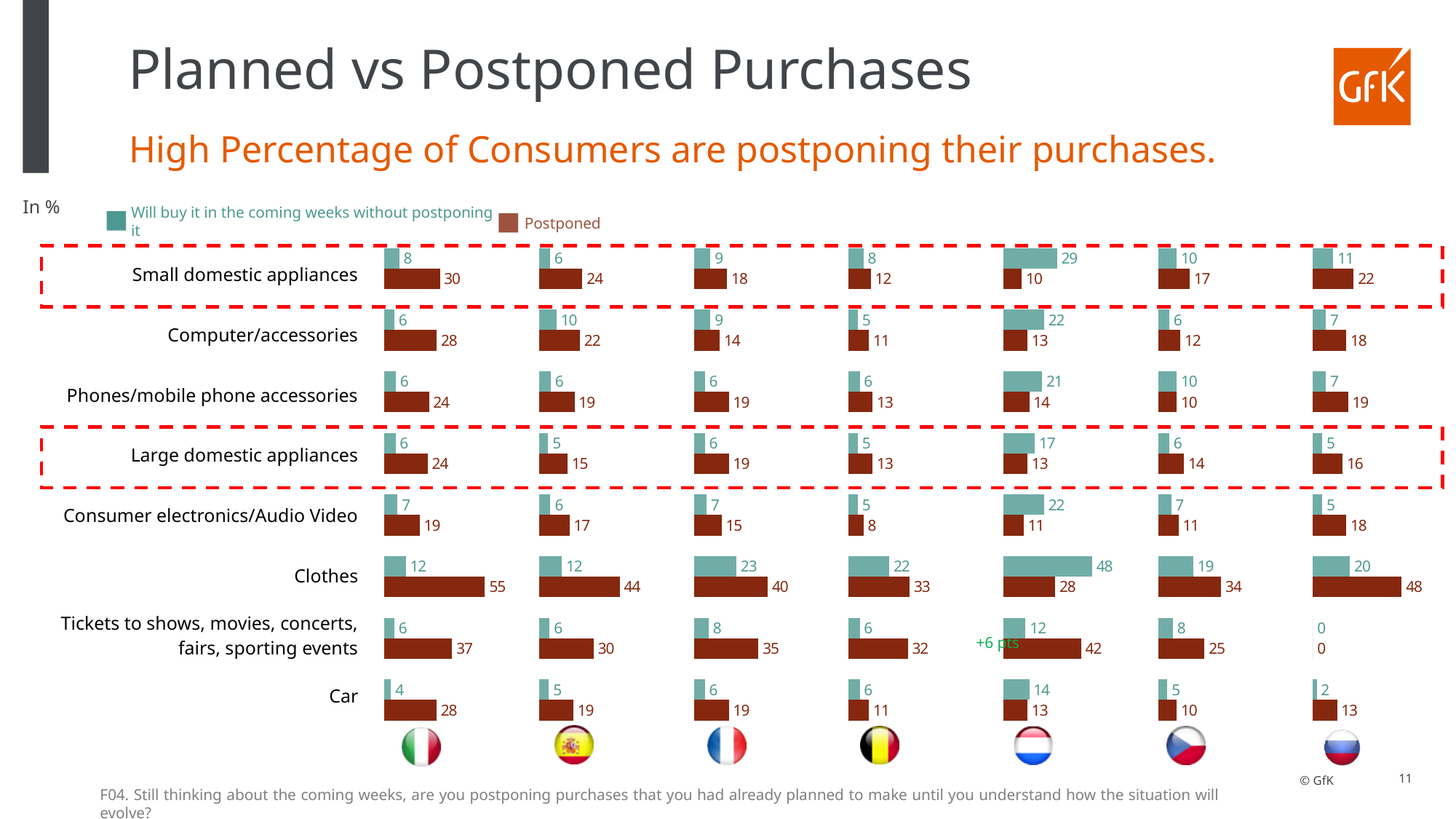
In the leftmost column of charts, what is the Postponed value for Clothes? 55 In the rightmost column of charts, which is larger for Clothes: the Postponed value or the 'Will buy' value? Postponed How many columns of country charts are shown on the slide? 7 How many product categories are shown on the slide? 8 How many series does the legend list? 2 In the leftmost column of charts, which category has the highest Postponed value? Clothes In the leftmost column of charts, which category has the lowest 'Will buy it in the coming weeks without postponing it' value? Car In the leftmost column of charts, what is the total of the 'Will buy' and Postponed values for Clothes? 67 In the fifth column of charts from the left, what is the 'Will buy it in the coming weeks without postponing it' value for Clothes? 48 In the leftmost column of charts, what is the difference between the Postponed value and the 'Will buy' value for Small domestic appliances? 22 What kind of chart is used on this slide? Bar chart In the rightmost column of charts, what is the Postponed value for Tickets to shows, movies, concerts, fairs, sporting events? 0